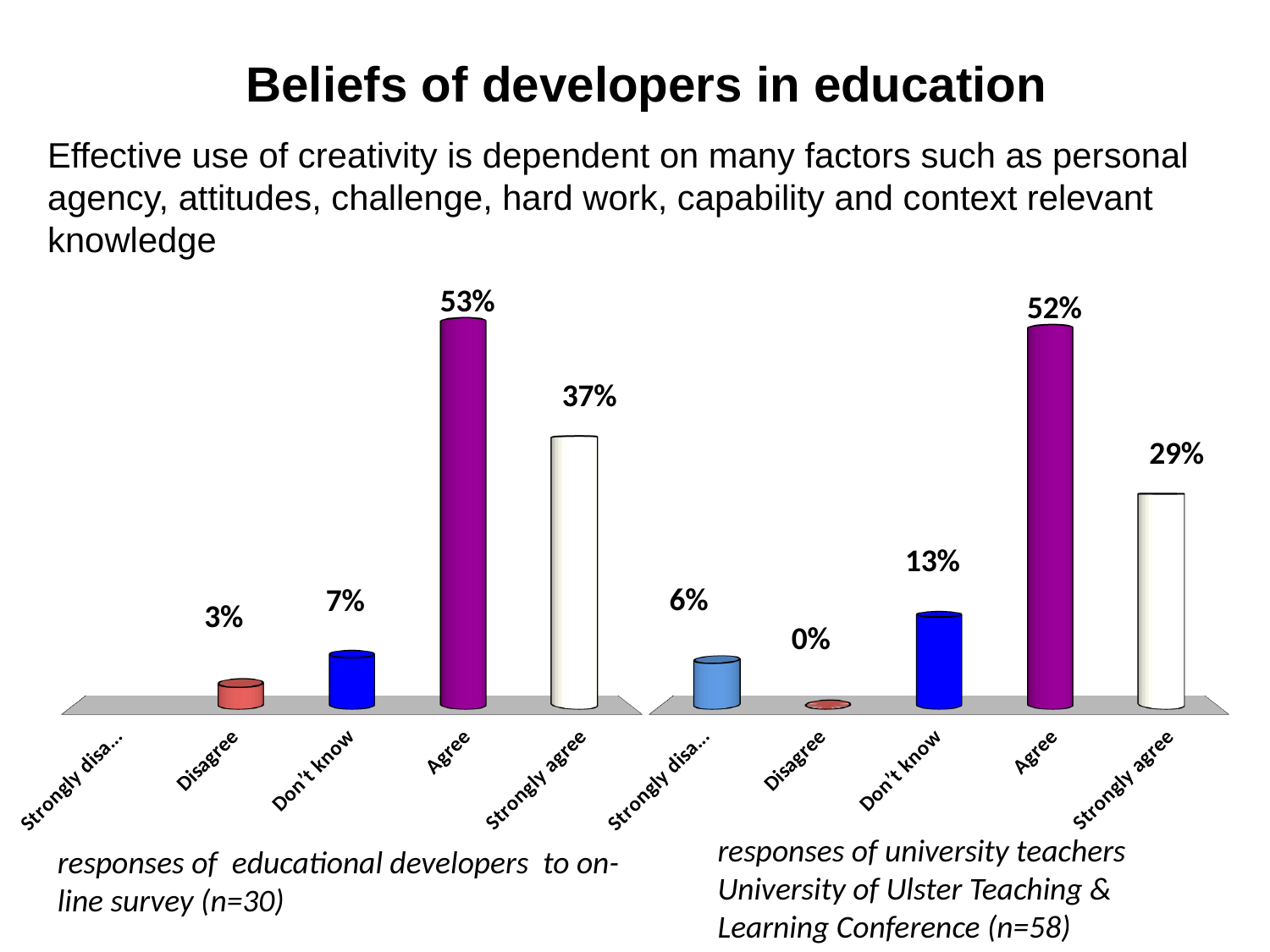
In the left chart (responses of educational developers), what percentage chose Strongly agree? 37% What is the title of the slide containing the two charts? Beliefs of developers in education In the right chart (responses of university teachers), which category has the lowest value? Disagree In the right chart (responses of university teachers), what percentage chose Don't know? 13% What kind of chart is the right chart (responses of university teachers)? Bar chart In the right chart (responses of university teachers), what percentage chose Disagree? 0% In the right chart (responses of university teachers), what is the difference between Agree and Strongly agree? 23% In the left chart (responses of educational developers), what is the difference between Agree and Strongly agree? 16% Which is larger: Don't know in the left chart (educational developers) or Don't know in the right chart (university teachers)? Right chart (university teachers), 13% In the right chart (responses of university teachers), which category has the highest value? Agree In the left chart (responses of educational developers), what percentage chose Agree? 53% How many categories are shown on the x axis of the left chart (responses of educational developers)? 5